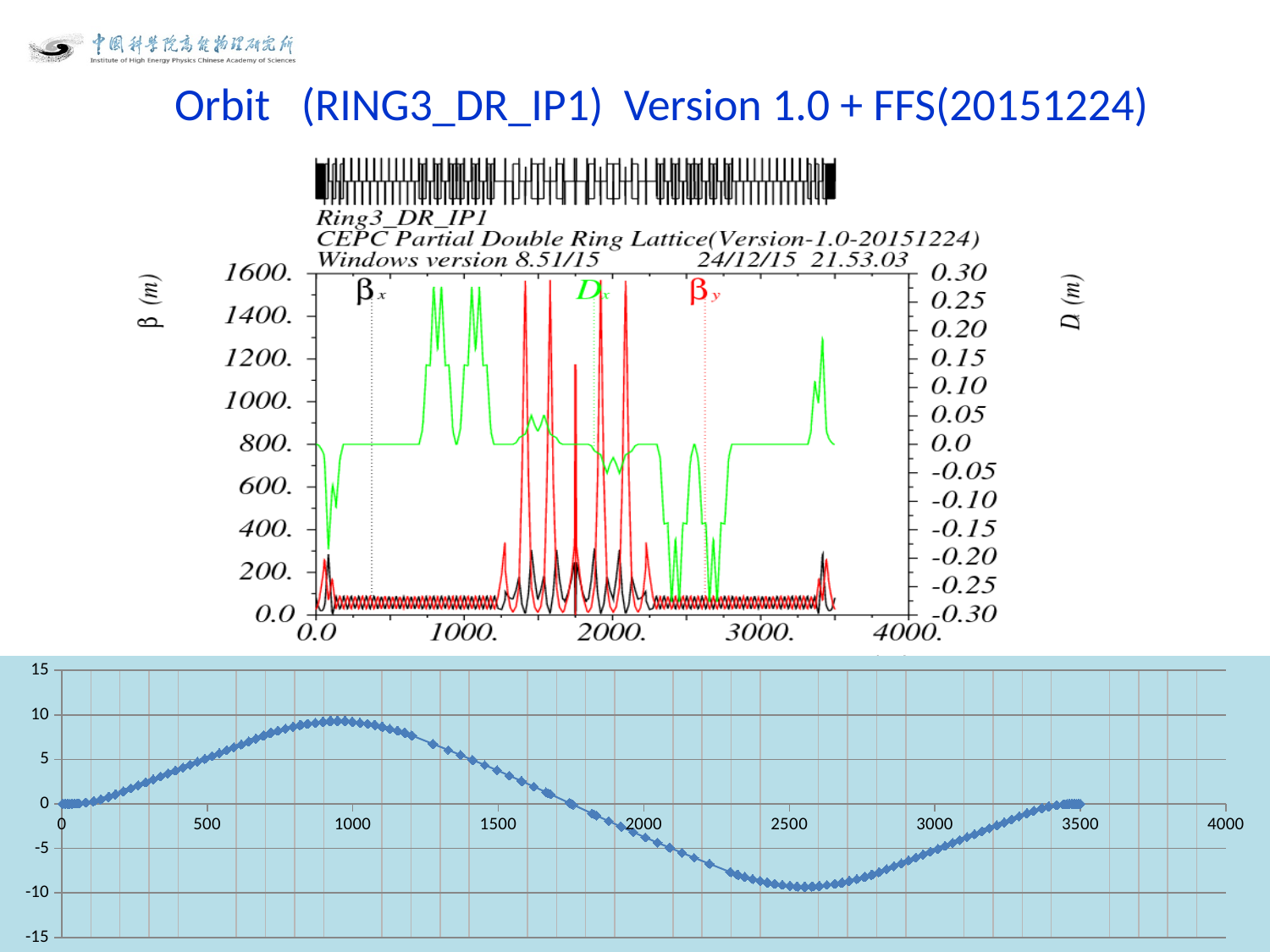
In the bottom chart, is the value at x = 1000 greater or less than 5? greater In the bottom chart, do the values rise or fall as x goes from 0 to 900? rise In the bottom chart, do the values rise or fall as x goes from 1000 to 2500? fall In the bottom chart, what is the maximum value shown on the vertical axis? 15 What kind of chart is the bottom chart on the slide? line chart In the top lattice chart, which curve reaches the higher β value, βx or βy? βy How many curves are labelled in the top lattice chart (βx, Dx, βy)? 3 In the bottom chart, what is the largest value labelled on the horizontal axis? 4000 In the bottom chart, is the value at x = 1000 larger or smaller than the value at x = 2500? larger In the bottom chart, is the value at x = 2500 greater or less than -5? less In the bottom chart, is the value at x = 1500 greater or less than 0? greater